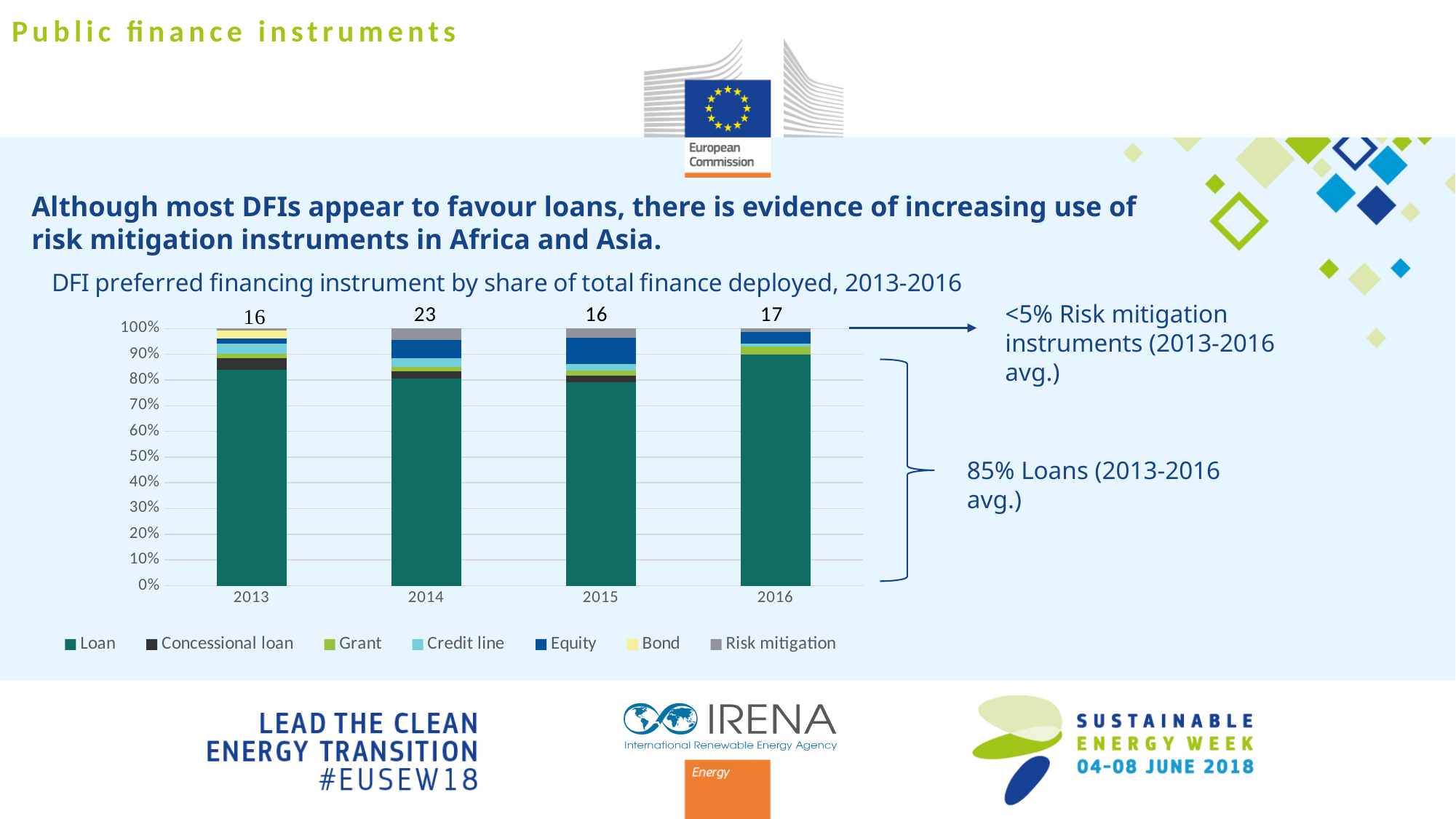
How many series does the chart legend list? 7 How many years (categories) are shown on the x axis of the chart? 4 What is the title of the chart? DFI preferred financing instrument by share of total finance deployed, 2013-2016 Which year has the largest Loan share? 2016 What kind of chart is shown on the slide? Stacked bar chart Is the Loan share in 2016 greater or less than 80%? greater Is the Loan share in 2015 greater or less than 90%? less Is the Loan share in 2013 greater or less than 80%? greater What number is printed above the 2014 bar? 23 Which year has the largest number printed above its bar? 2014 According to the annotation next to the chart, what is the average share of loans for 2013-2016? 85% What number is printed above the 2016 bar? 17